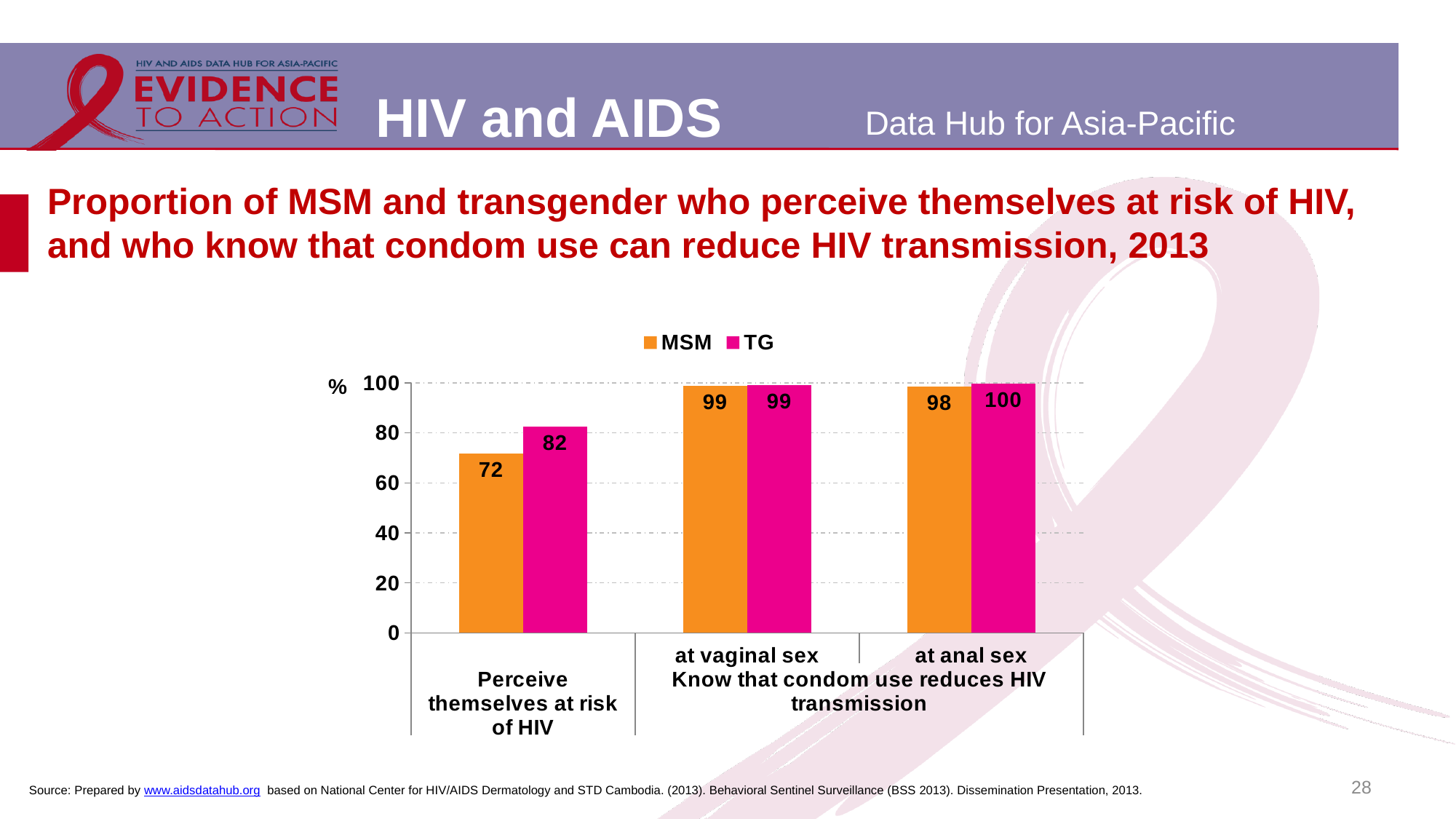
What is the difference between the TG and MSM values for 'Perceive themselves at risk of HIV'? 10 How many categories are shown on the x axis? 3 Is the MSM value for 'Perceive themselves at risk of HIV' greater or less than 80? less What is the TG value for knowing that condom use reduces HIV transmission at anal sex? 100 What is the MSM value for knowing that condom use reduces HIV transmission at anal sex? 98 What is the TG value for 'Perceive themselves at risk of HIV'? 82 What colour are the TG bars? pink Which category has the lowest MSM value? Perceive themselves at risk of HIV What kind of chart is shown on the slide? bar chart For 'Perceive themselves at risk of HIV', which series has the larger value, MSM or TG? TG How many series does the legend list? 2 What is the MSM value for 'Perceive themselves at risk of HIV'? 72